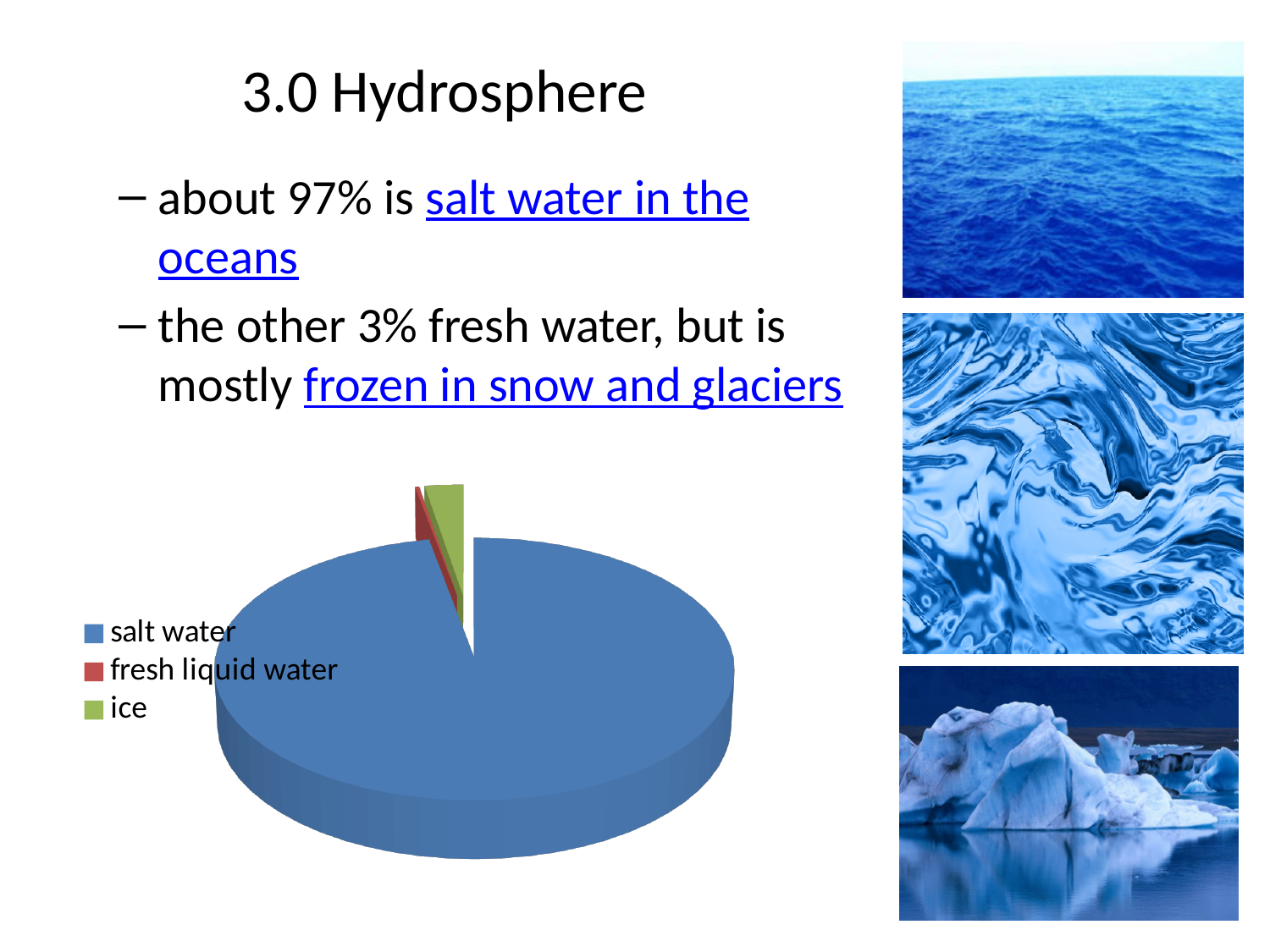
Which slice is larger in the pie chart, ice or fresh liquid water? ice What kind of chart is shown on the slide? pie chart Which category has the largest slice in the pie chart? salt water What colour is the salt water slice in the pie chart? blue How many entries does the pie chart's legend list? 3 How many slices does the pie chart have? 3 Which category has the smallest slice in the pie chart? fresh liquid water Which category is shown in green in the pie chart? ice Which slice is larger in the pie chart, salt water or ice? salt water